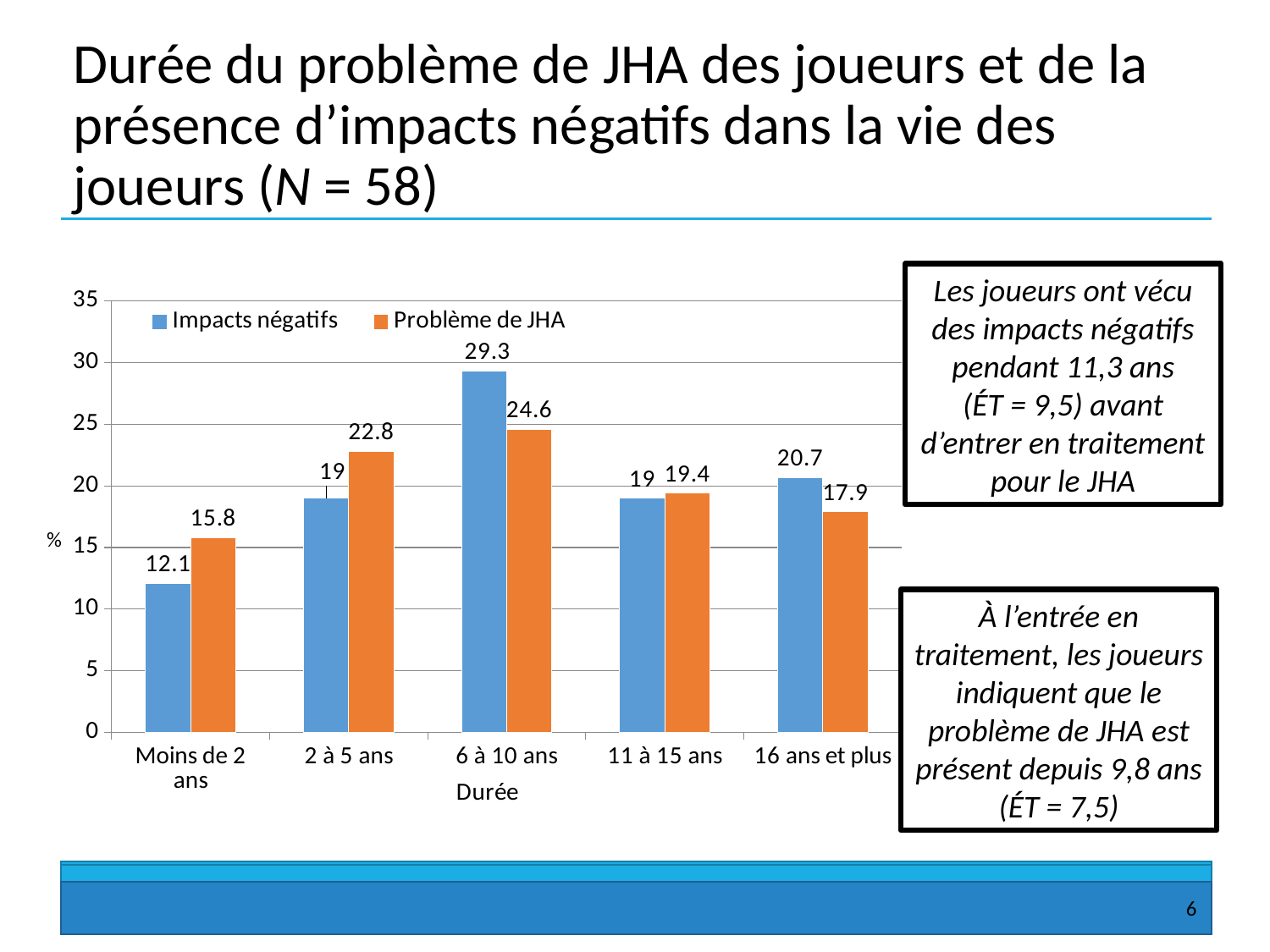
How many series does the legend list? 2 Which category has the highest value for Impacts négatifs? 6 à 10 ans What kind of chart is shown on the slide? Bar chart In the 2 à 5 ans category, which series has the larger value, Impacts négatifs or Problème de JHA? Problème de JHA What is the difference between Impacts négatifs and Problème de JHA in the 6 à 10 ans category? 4.7 How many duration categories are shown on the x axis? 5 Is the value for Impacts négatifs in the 16 ans et plus category greater or less than 20? greater What is the value for Problème de JHA in the Moins de 2 ans category? 15.8 What is the label of the x axis? Durée Which category has the lowest value for Problème de JHA? Moins de 2 ans What is the value for Problème de JHA in the 16 ans et plus category? 17.9 What is the value for Impacts négatifs in the 6 à 10 ans category? 29.3